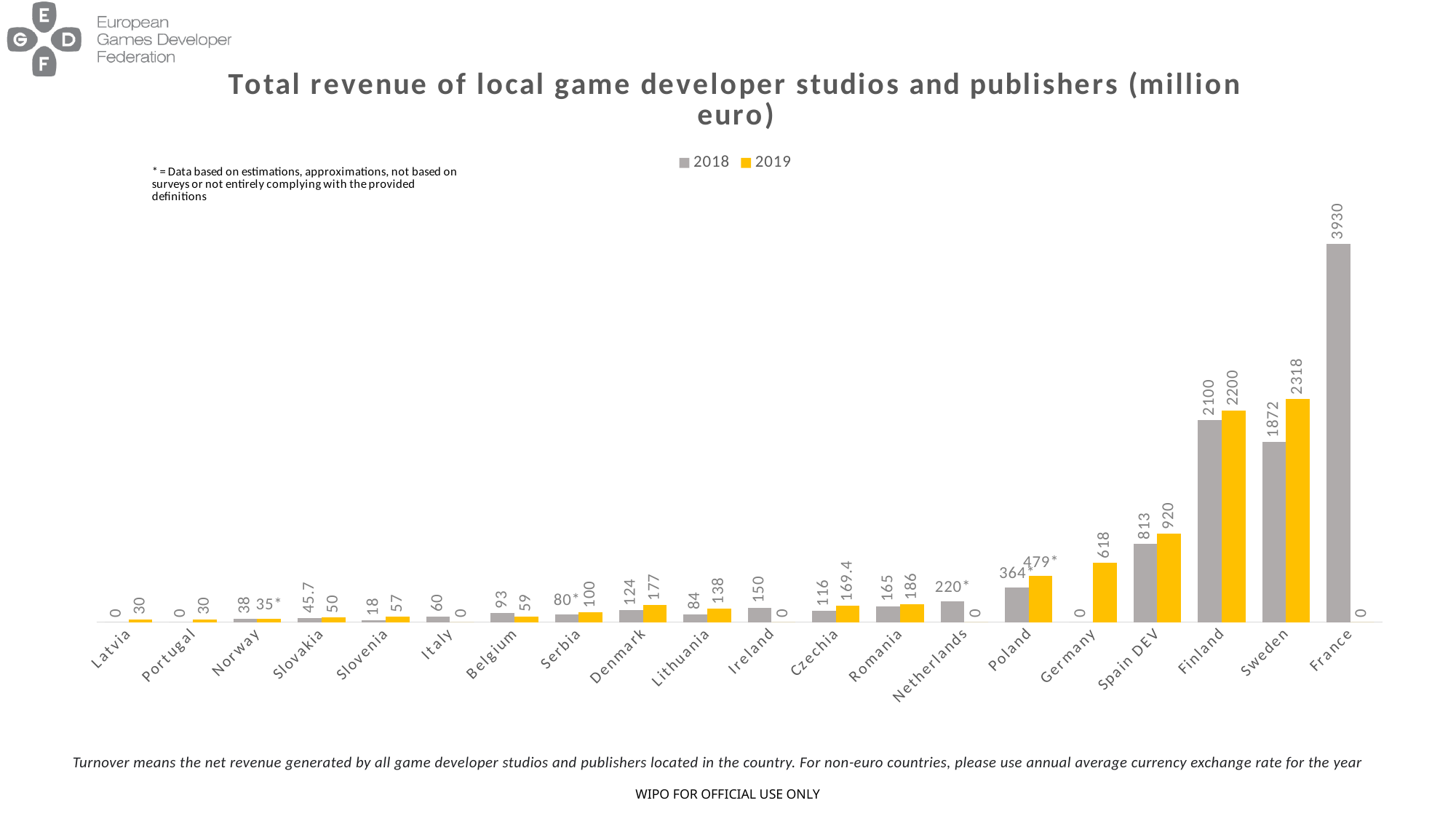
How many series does the legend list? 2 What is the 2019 value for Finland? 2200 What is the 2018 value for Slovakia? 45.7 What is the 2018 value for Sweden? 1872 Which country has the highest 2019 value? Sweden Which country has the highest 2018 value? France What is the 2019 value for Germany? 618 How many countries are shown on the x axis? 20 What is the 2019 value for Czechia? 169.4 Which is larger for Belgium, the 2018 value or the 2019 value? 2018 What kind of chart is shown on the slide? bar chart What is the difference between the 2019 and 2018 values for Spain DEV? 107